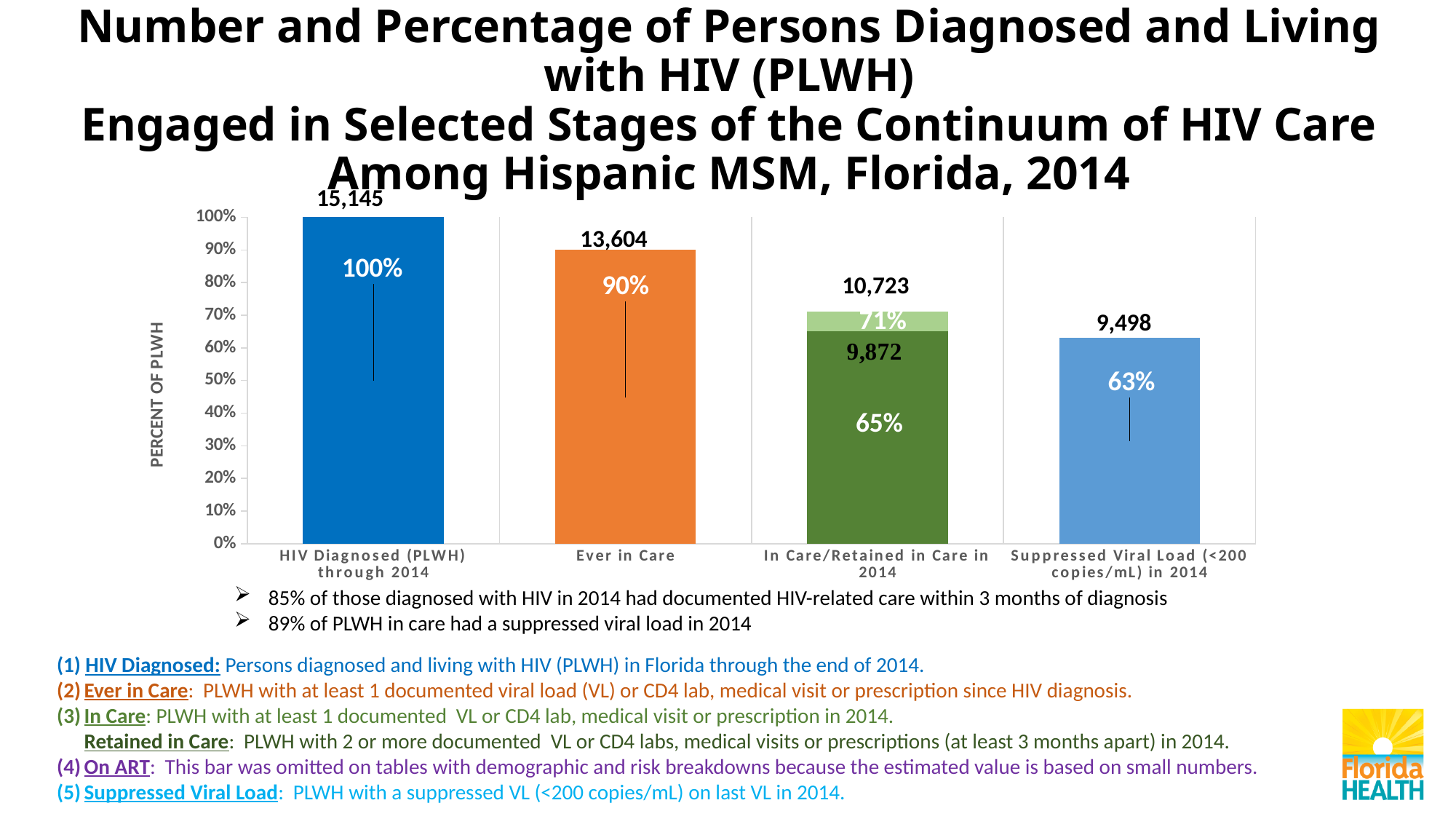
What is the difference in number of persons between 'HIV Diagnosed (PLWH) through 2014' and 'Ever in Care'? 1,541 What kind of chart is shown on the slide? bar chart What percentage is shown for the 'Retained in Care' (dark green) portion of the 'In Care/Retained in Care in 2014' bar? 65% Do the percentages rise or fall moving from left to right along the x axis? fall What is the number of persons labelled on the 'HIV Diagnosed (PLWH) through 2014' bar? 15,145 What is the number of persons labelled at the top of the 'In Care/Retained in Care in 2014' bar? 10,723 Which category has the lowest percentage of PLWH? Suppressed Viral Load (<200 copies/mL) in 2014 Which is larger: the percentage for 'Ever in Care' or the percentage for 'Suppressed Viral Load (<200 copies/mL) in 2014'? Ever in Care How many categories are shown on the x axis of the chart? 4 Which category has the highest number of persons? HIV Diagnosed (PLWH) through 2014 What is the number of persons labelled on the 'Ever in Care' bar? 13,604 What percentage is shown on the 'Suppressed Viral Load (<200 copies/mL) in 2014' bar? 63%